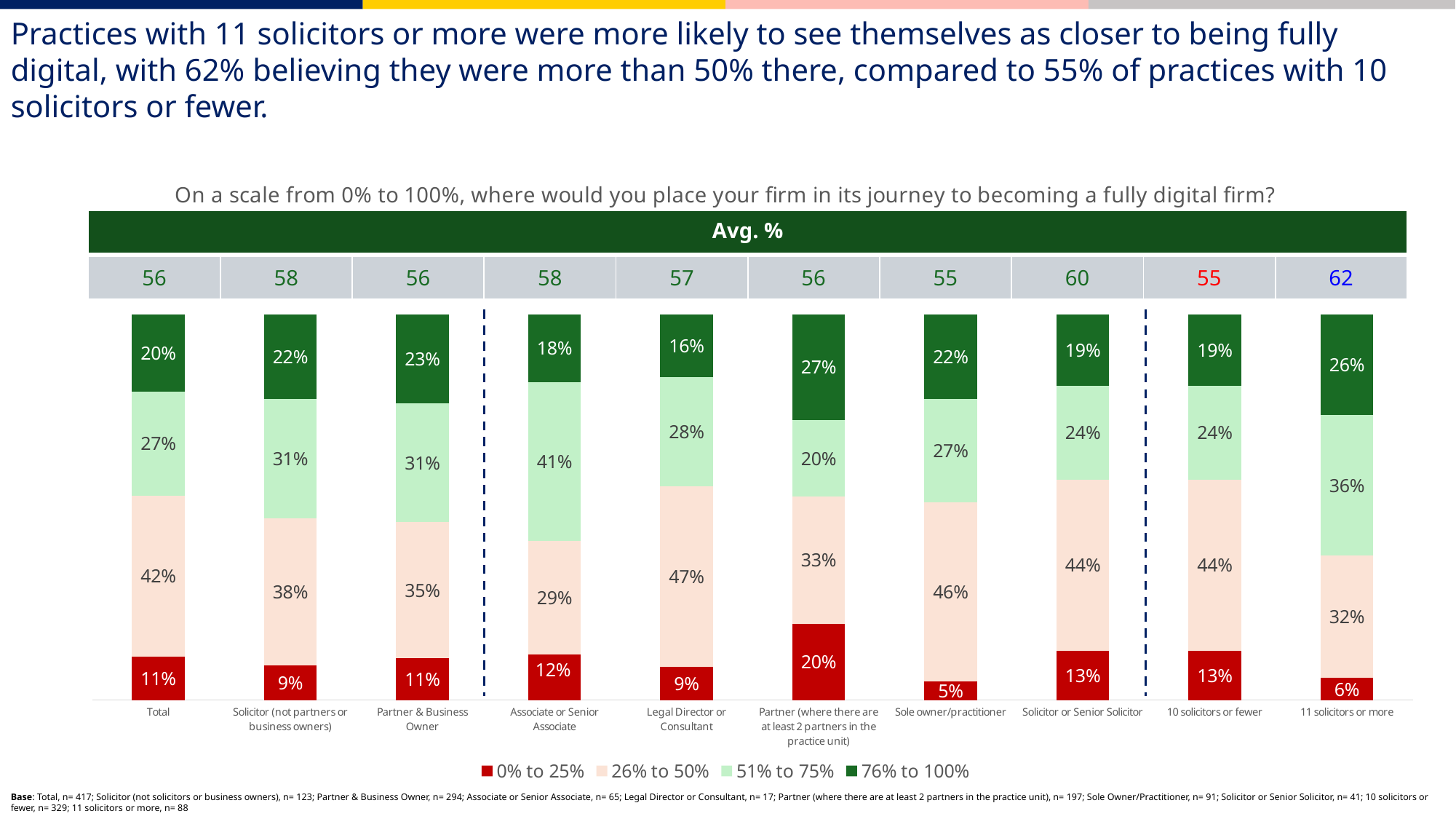
What is the Avg. % shown for Solicitor or Senior Solicitor? 60 Which category has the highest Avg. % value? 11 solicitors or more Which has a larger 51% to 75% share: Associate or Senior Associate, or Legal Director or Consultant? Associate or Senior Associate How many categories are shown along the x axis of the chart? 10 What is the difference between the 26% to 50% value for Total and the 26% to 50% value for 11 solicitors or more? 10 percentage points Which category has the highest share in the 0% to 25% band? Partner (where there are at least 2 partners in the practice unit) What percentage of practices with 11 solicitors or more placed themselves in the 76% to 100% band? 26% What question is the chart based on, as shown in its title? On a scale from 0% to 100%, where would you place your firm in its journey to becoming a fully digital firm? How many series does the legend list? 4 What is the 0% to 25% value for Sole owner/practitioner? 5% Which category has the lowest share in the 0% to 25% band? Sole owner/practitioner What kind of chart is shown on the slide? Stacked bar chart